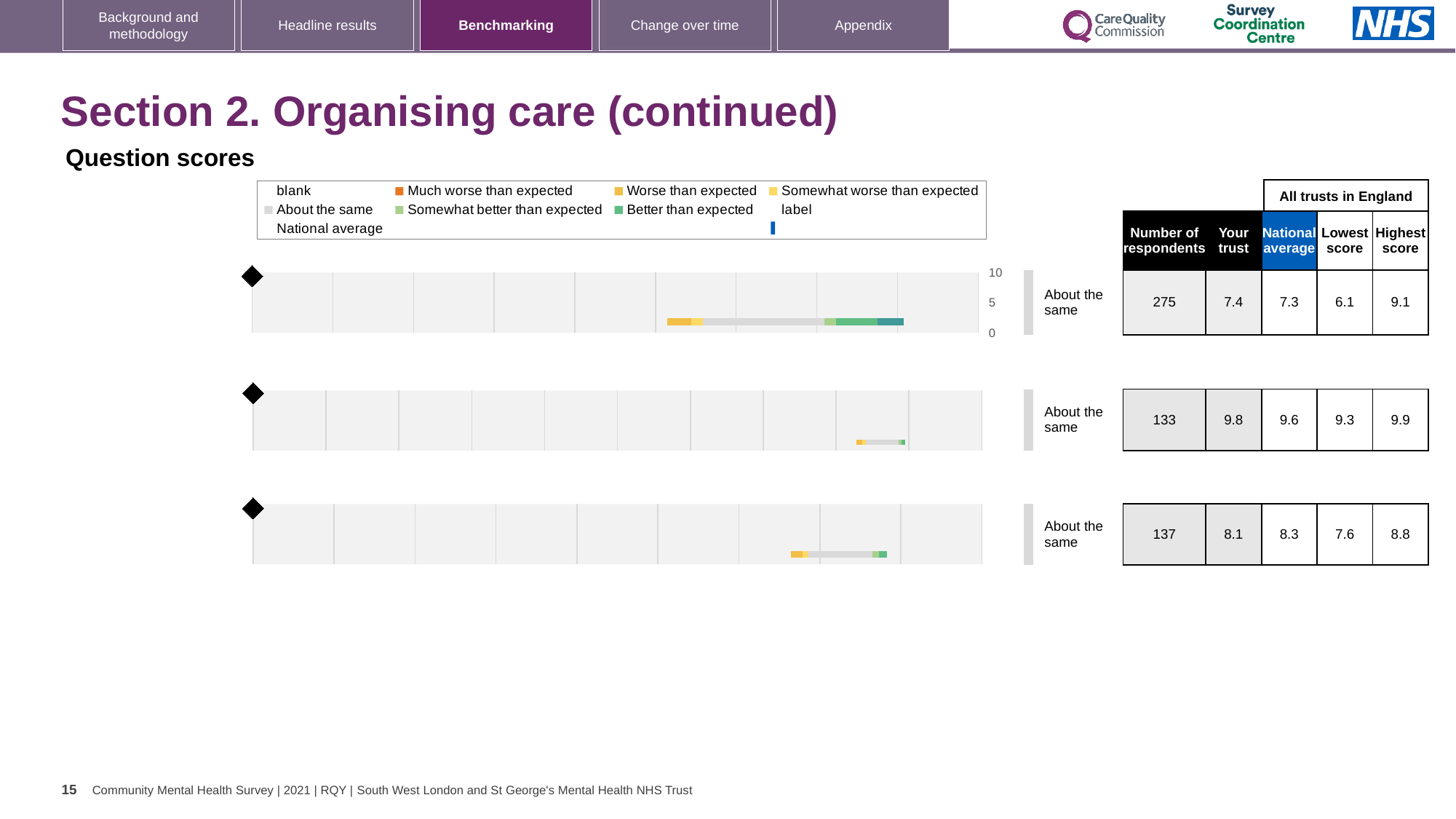
In the middle chart's table, what is the national average score? 9.6 What kind of chart is used to show the question scores on this slide? Bar chart In the top chart, is the 'Your trust' score greater or less than 5? greater In the top chart's table, what is the 'Your trust' score? 7.4 How many question score charts are shown on the slide? 3 For the middle chart, what is the difference between the highest score and the lowest score? 0.6 For the bottom chart, which is larger: the 'Your trust' score or the national average? National average Which chart (top, middle or bottom) has the highest 'Your trust' score? Middle In the top chart's table, what is the number of respondents? 275 Which legend entry is shown in orange? Much worse than expected For the top chart, which is larger: the 'Your trust' score or the national average? Your trust In the bottom chart's table, what is the lowest score among all trusts in England? 7.6